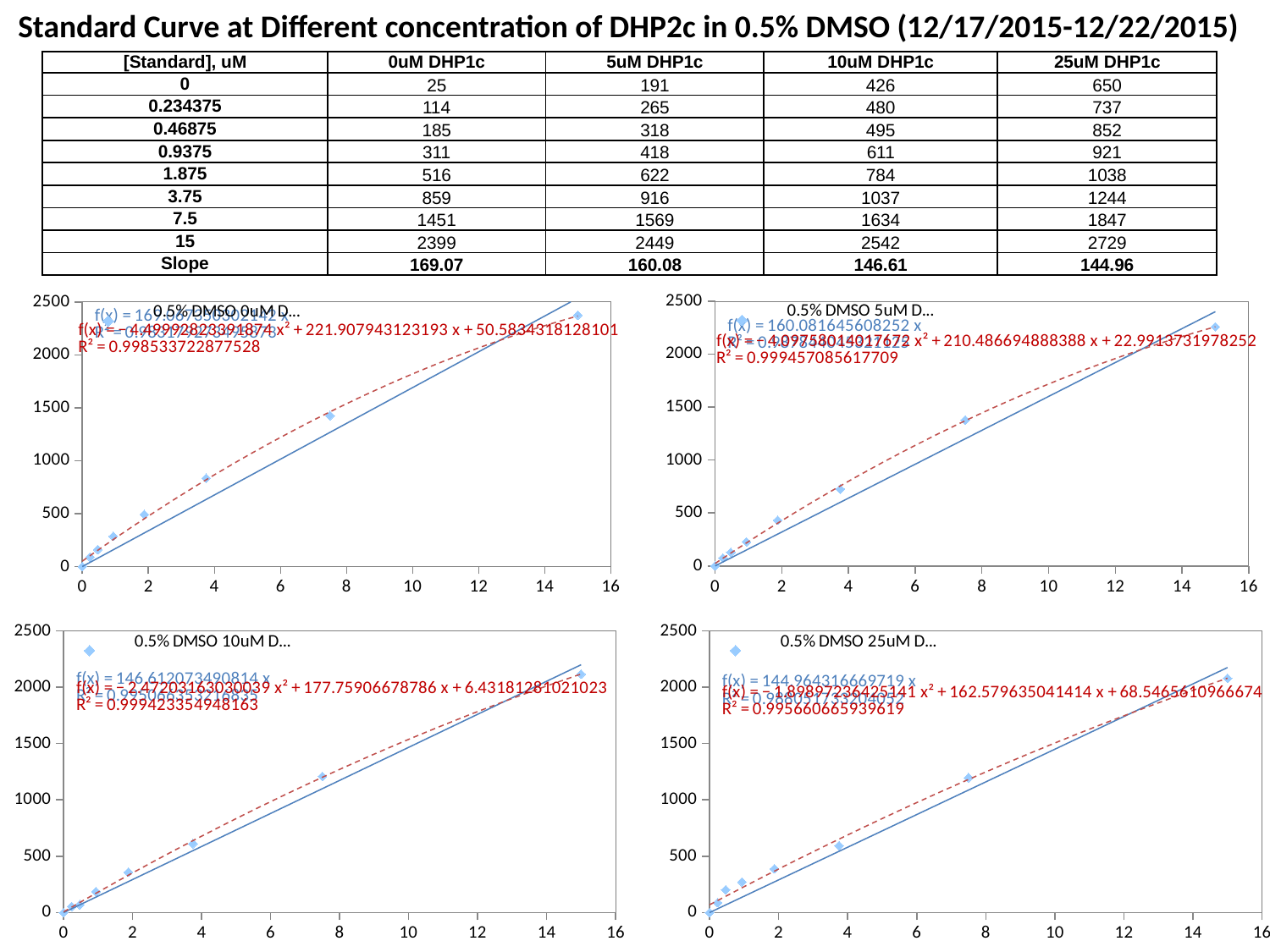
In the bottom-left chart (0.5% DMSO 10uM), is the value of the point at x = 15 greater or less than 2000? greater In the top-left chart (0.5% DMSO 0uM), is the value of the point at x = 7.5 greater or less than 1500? less In the top-left chart (0.5% DMSO 0uM), do the plotted values rise or fall as x increases? rise What is the maximum value shown on the y axis of the top-left chart (0.5% DMSO 0uM)? 2500 In the top-right chart (0.5% DMSO 5uM), is the value of the point at x = 3.75 greater or less than 500? greater What kind of chart is the top-left chart titled '0.5% DMSO 0uM D...'? scatter chart How many charts are shown on the slide? 4 What R² value is printed in red for the polynomial fit in the top-right chart (0.5% DMSO 5uM)? 0.999457085617709